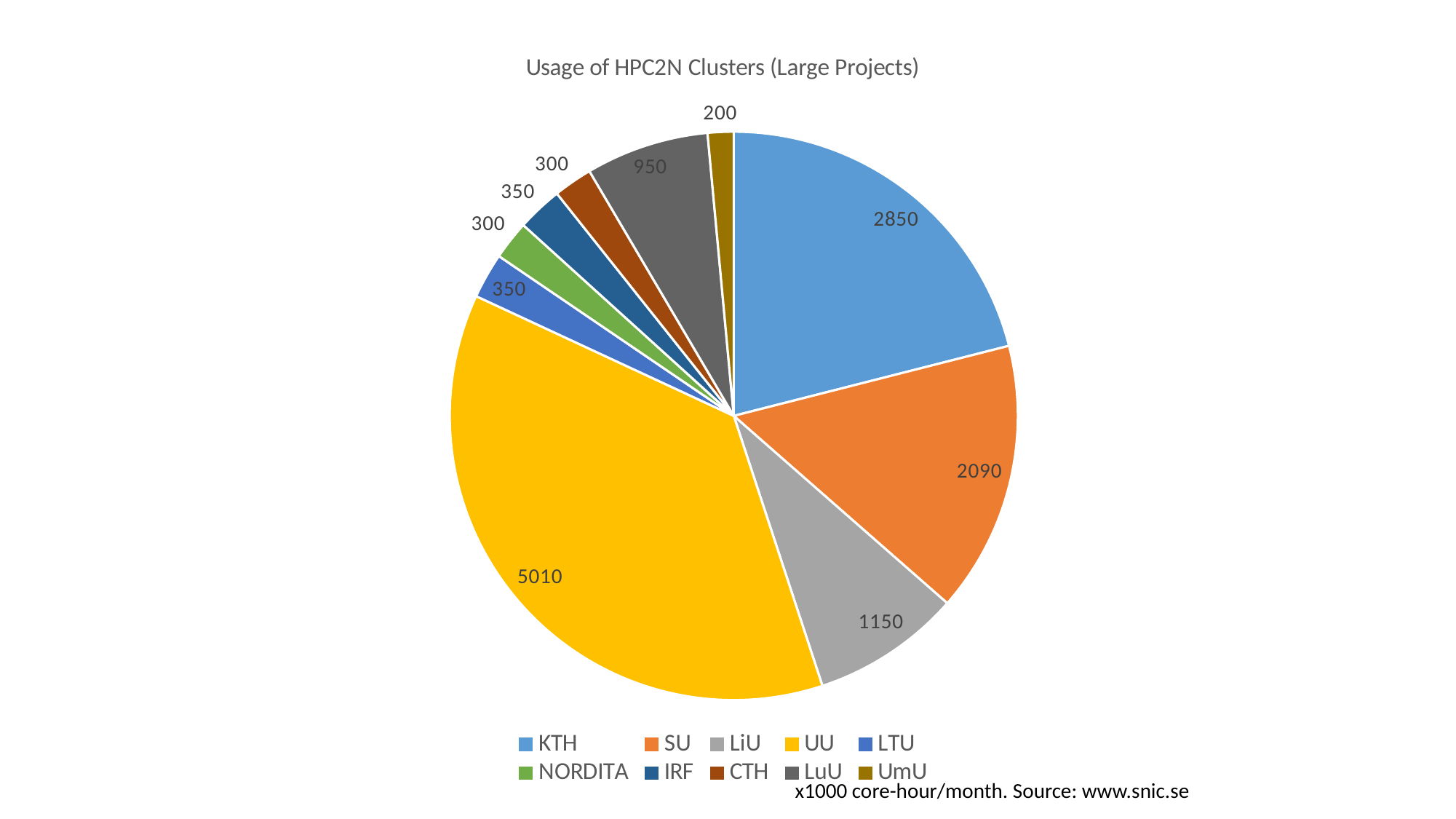
What is the value for KTH? 2850 Which is larger, the value for SU or the value for LiU? SU What type of chart is shown on the slide? Pie chart How many categories does the legend list? 10 Which category has the largest slice? UU What is the value for UU? 5010 What is the title of the chart? Usage of HPC2N Clusters (Large Projects) What is the difference between the values for UU and KTH? 2160 Which category has the smallest slice? UmU What is the difference between the values for KTH and SU? 760 What is the value for LuU? 950 What colour is the slice for UU? Yellow